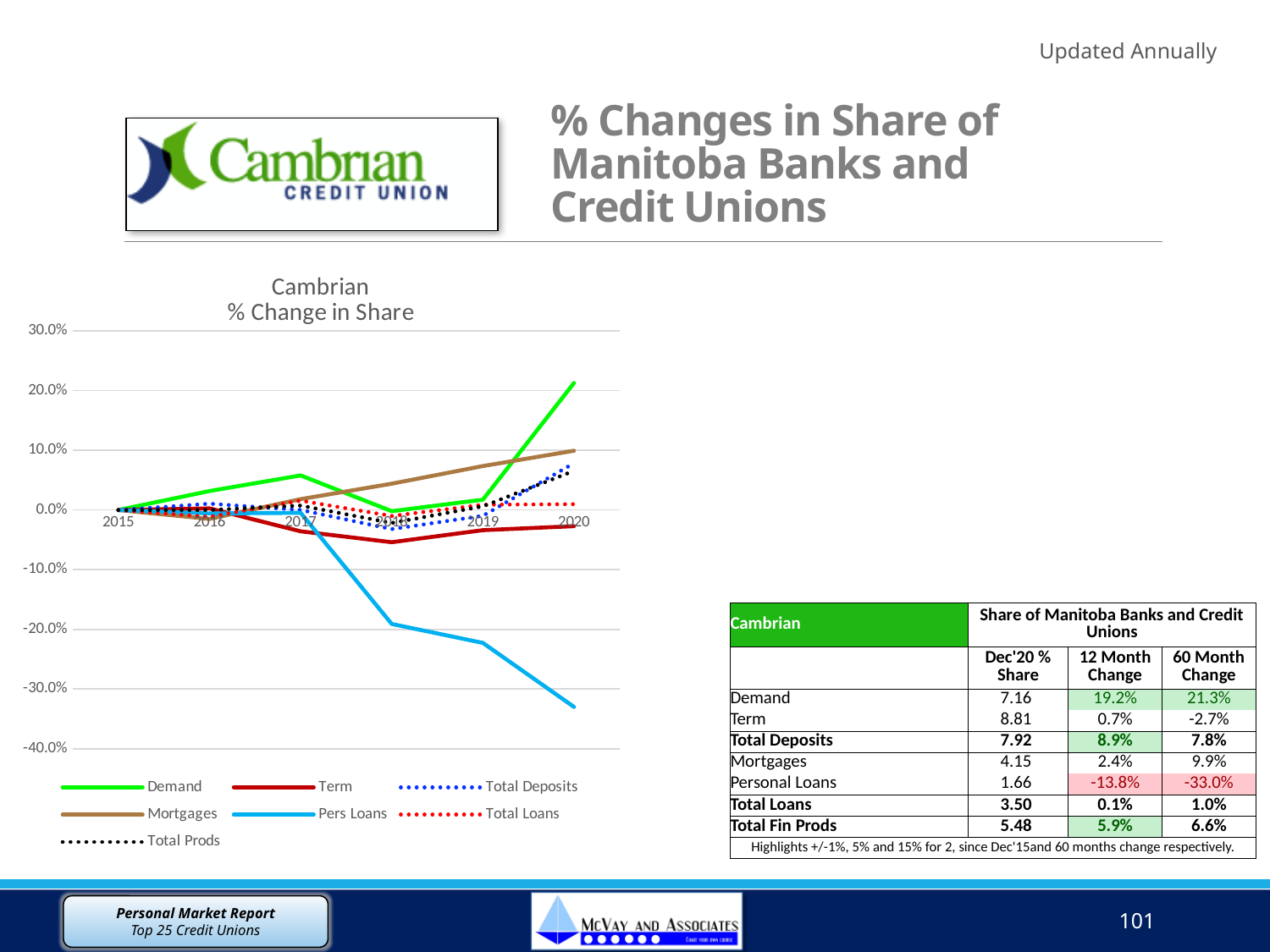
Is the value for Pers Loans in 2020 greater or less than -30.0%? less What colour is the Demand line on the "Cambrian % Change in Share" chart? green How many years are shown on the x axis of the "Cambrian % Change in Share" chart? 6 Which series has the highest value in 2020 on the "Cambrian % Change in Share" chart? Demand Is the value for Pers Loans in 2018 greater or less than -10.0%? less Which series has the lowest value in 2020 on the "Cambrian % Change in Share" chart? Pers Loans Does the Pers Loans line rise or fall from 2017 to 2020? fall How many series does the legend of the "Cambrian % Change in Share" chart list? 7 What kind of chart is the "Cambrian % Change in Share" chart? line chart Is the value for Demand in 2020 greater or less than 10.0%? greater Which is larger in 2020, the value for Demand or the value for Pers Loans? Demand